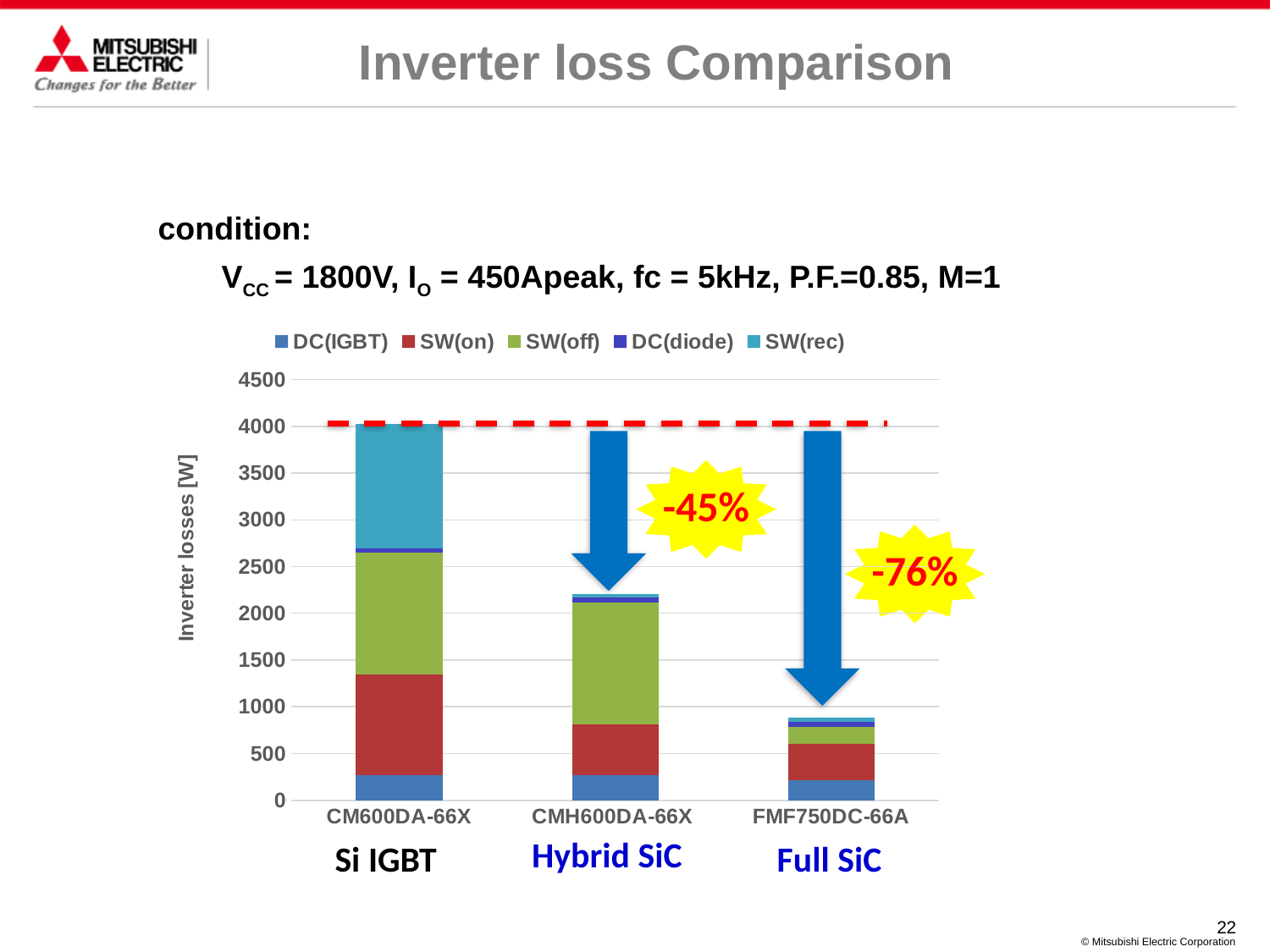
What percentage reduction in inverter losses is annotated for the Hybrid SiC module (CMH600DA-66X)? -45% Is the total inverter loss for CMH600DA-66X greater or less than 2500 W? less Is the total inverter loss for FMF750DC-66A greater or less than 1000 W? less Which has larger total inverter losses, CMH600DA-66X or FMF750DC-66A? CMH600DA-66X What percentage reduction in inverter losses is annotated for the Full SiC module (FMF750DC-66A)? -76% Do the total inverter losses rise or fall moving from left to right across the three modules? fall How many modules (categories) are compared on the x axis of the chart? 3 Is the total inverter loss for CM600DA-66X greater or less than 3500 W? greater Which module has the lowest total inverter losses? FMF750DC-66A Which module has the highest total inverter losses? CM600DA-66X How many series does the chart legend list? 5 What kind of chart is shown on the slide? Stacked bar chart